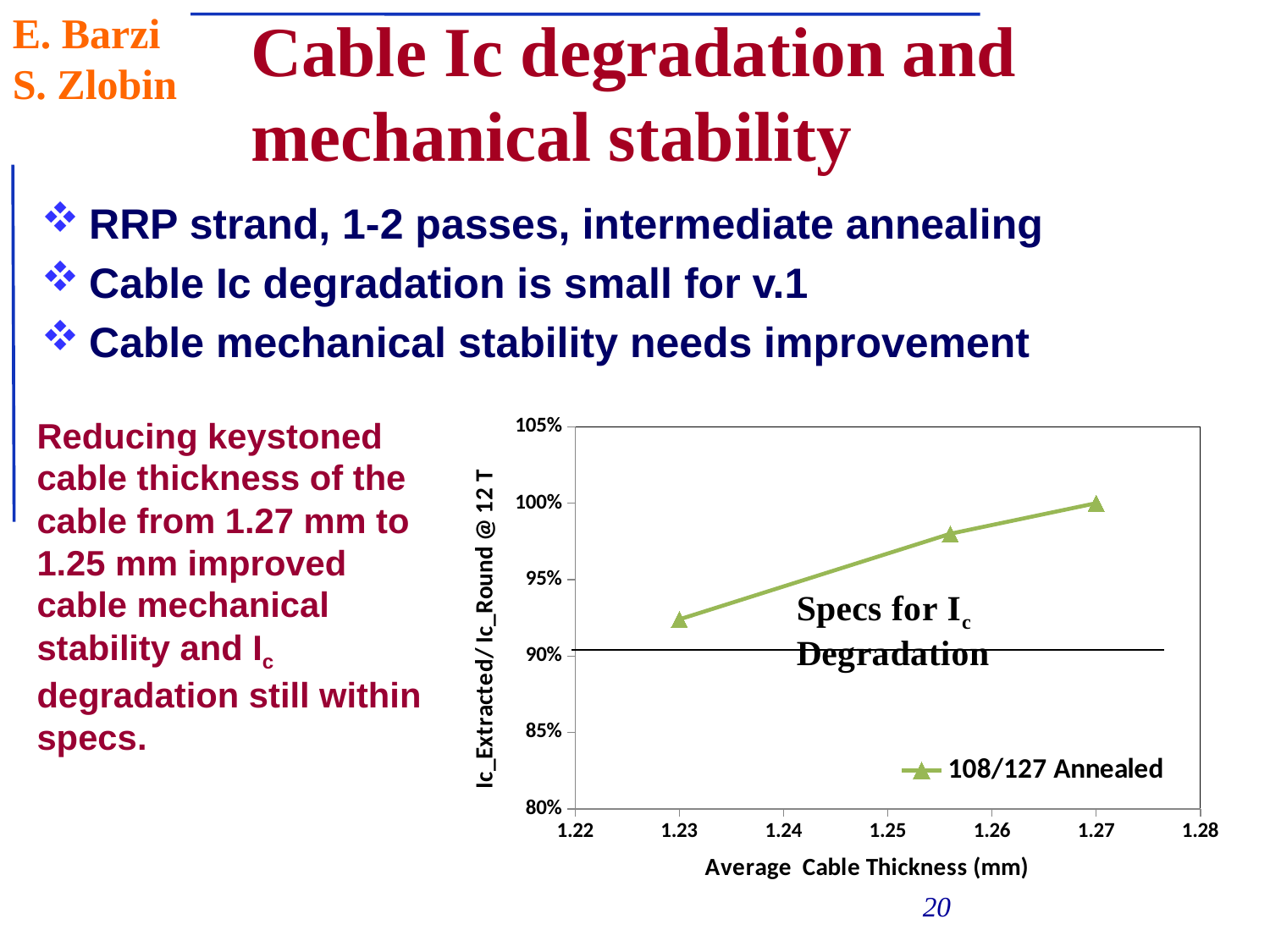
Is the value for the point at 1.27 mm greater or less than 95%? greater Is the value for the point at 1.23 mm greater or less than 95%? less Which point has the higher value: the one at 1.23 mm or the one at 1.27 mm? 1.27 mm What is the name of the series shown in the chart legend? 108/127 Annealed Do the plotted values rise or fall as average cable thickness increases along the x axis? Rise At which average cable thickness is the plotted value lowest? 1.23 How many data points are plotted on the chart? 3 What is the title of the x axis of the chart? Average Cable Thickness (mm) Is the value for the point at 1.23 mm greater or less than 90%? greater What kind of chart is shown on the slide? Line chart How many series does the chart legend list? 1 At which average cable thickness is the plotted value highest? 1.27